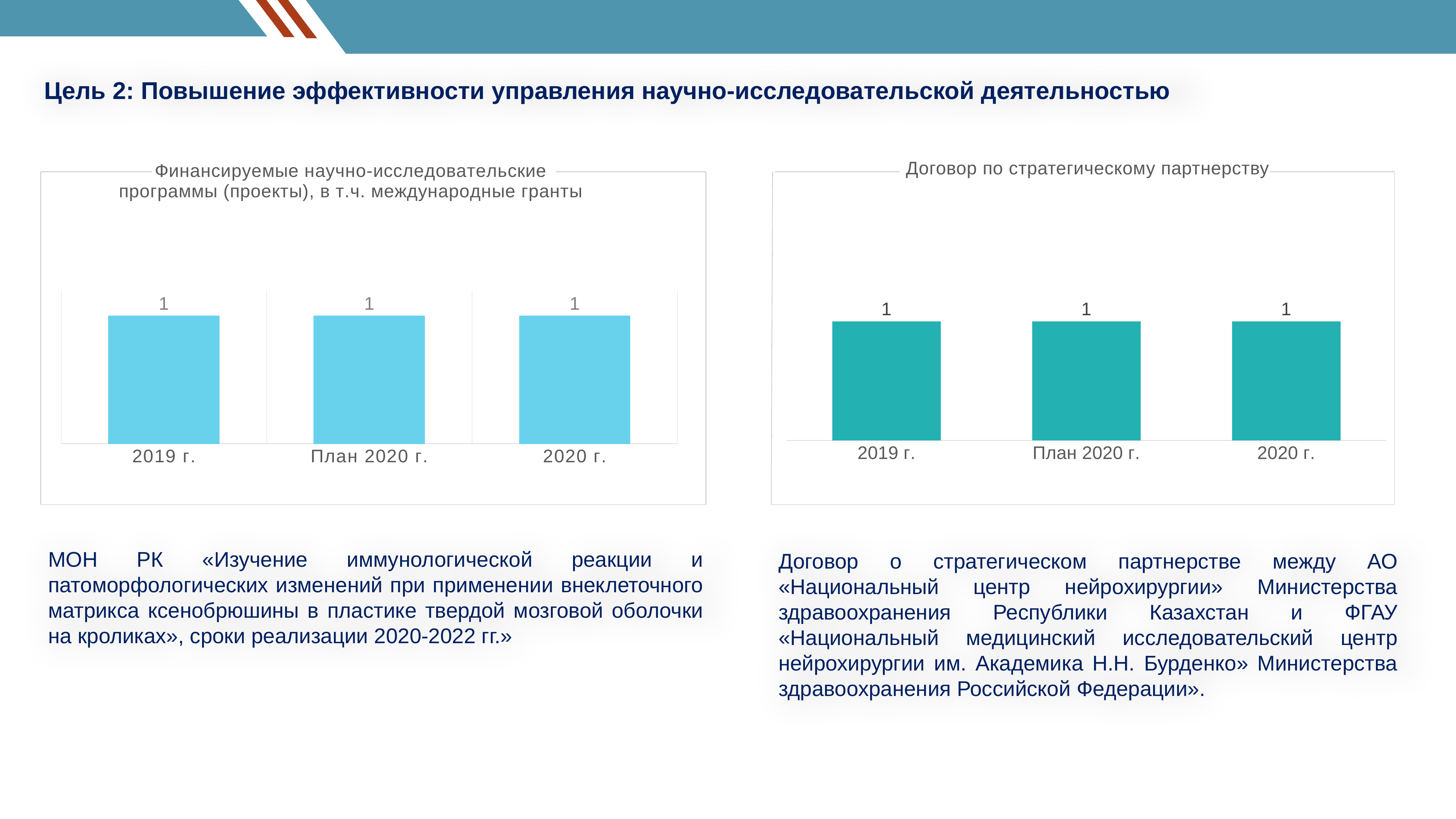
In the left chart (Финансируемые научно-исследовательские программы), what is the value for 2019 г.? 1 How many categories are shown in the right chart (Договор по стратегическому партнерству)? 3 In the left chart (Финансируемые научно-исследовательские программы), what is the value for 2020 г.? 1 How many categories are shown in the left chart (Финансируемые научно-исследовательские программы)? 3 In the left chart (Финансируемые научно-исследовательские программы), do the values rise, fall or stay the same from 2019 г. to 2020 г.? stay the same In the right chart (Договор по стратегическому партнерству), what is the difference between the values for 2020 г. and 2019 г.? 0 In the left chart (Финансируемые научно-исследовательские программы), what is the value for План 2020 г.? 1 In the right chart (Договор по стратегическому партнерству), what is the value for 2020 г.? 1 What kind of chart is the left chart (Финансируемые научно-исследовательские программы)? bar chart In the right chart (Договор по стратегическому партнерству), what is the value for 2019 г.? 1 What is the title of the right chart? Договор по стратегическому партнерству In the right chart (Договор по стратегическому партнерству), what is the value for План 2020 г.? 1